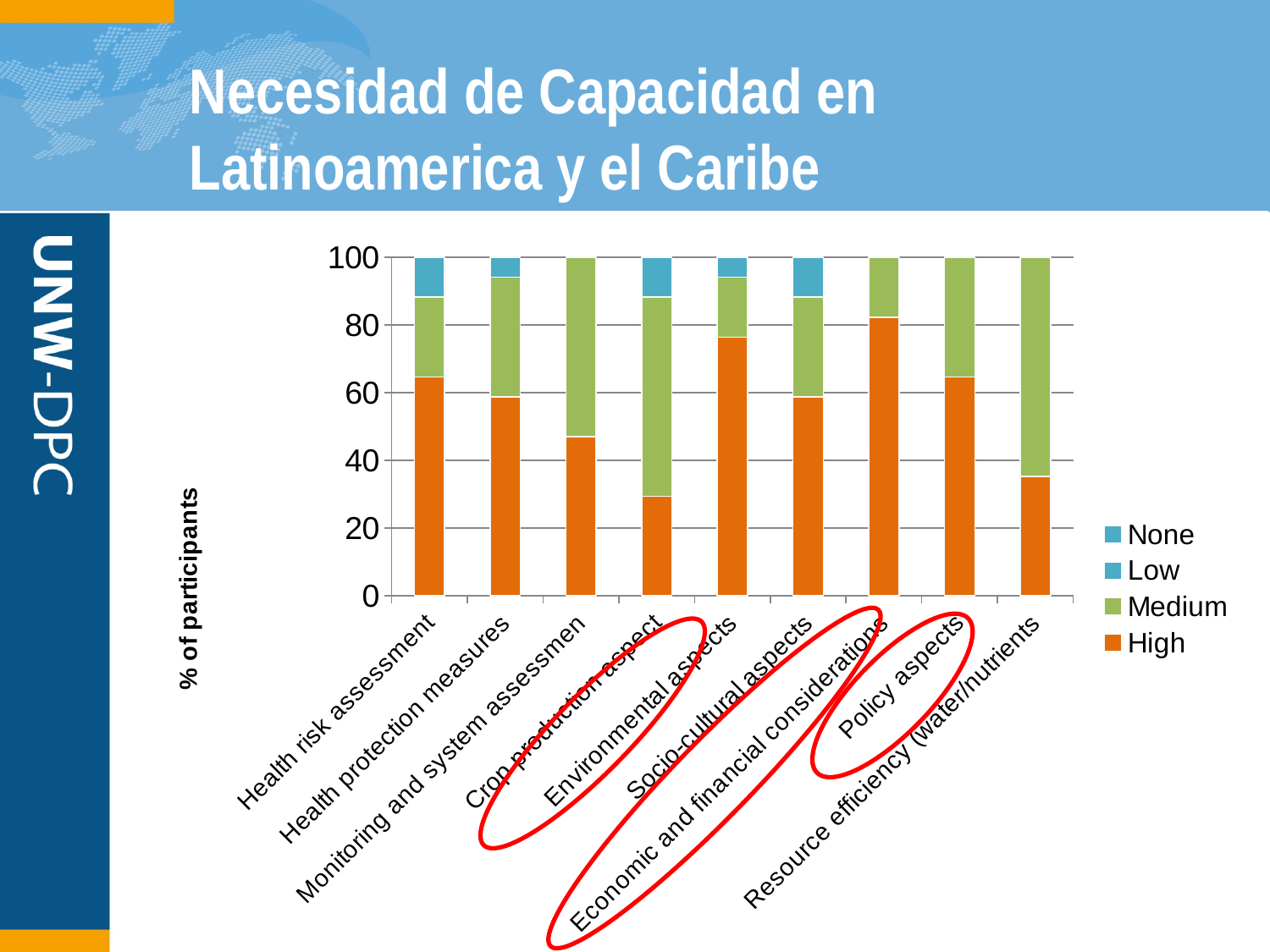
Is the 'High' value for Health risk assessment greater or less than 60? greater Which has the larger 'High' segment: Environmental aspects or Crop production aspect? Environmental aspects Which category has the largest 'High' segment? Economic and financial considerations What is the total height of the stacked bar for Policy aspects? 100 Which category has the smallest 'High' segment? Crop production aspect How many series does the chart's legend list? 4 How many categories are shown on the x axis of the chart? 9 Is the 'High' value for Environmental aspects greater or less than 60? greater What is the label on the chart's y axis? % of participants What kind of chart is shown on the slide? stacked bar chart Is the 'High' value for Crop production aspect greater or less than 40? less